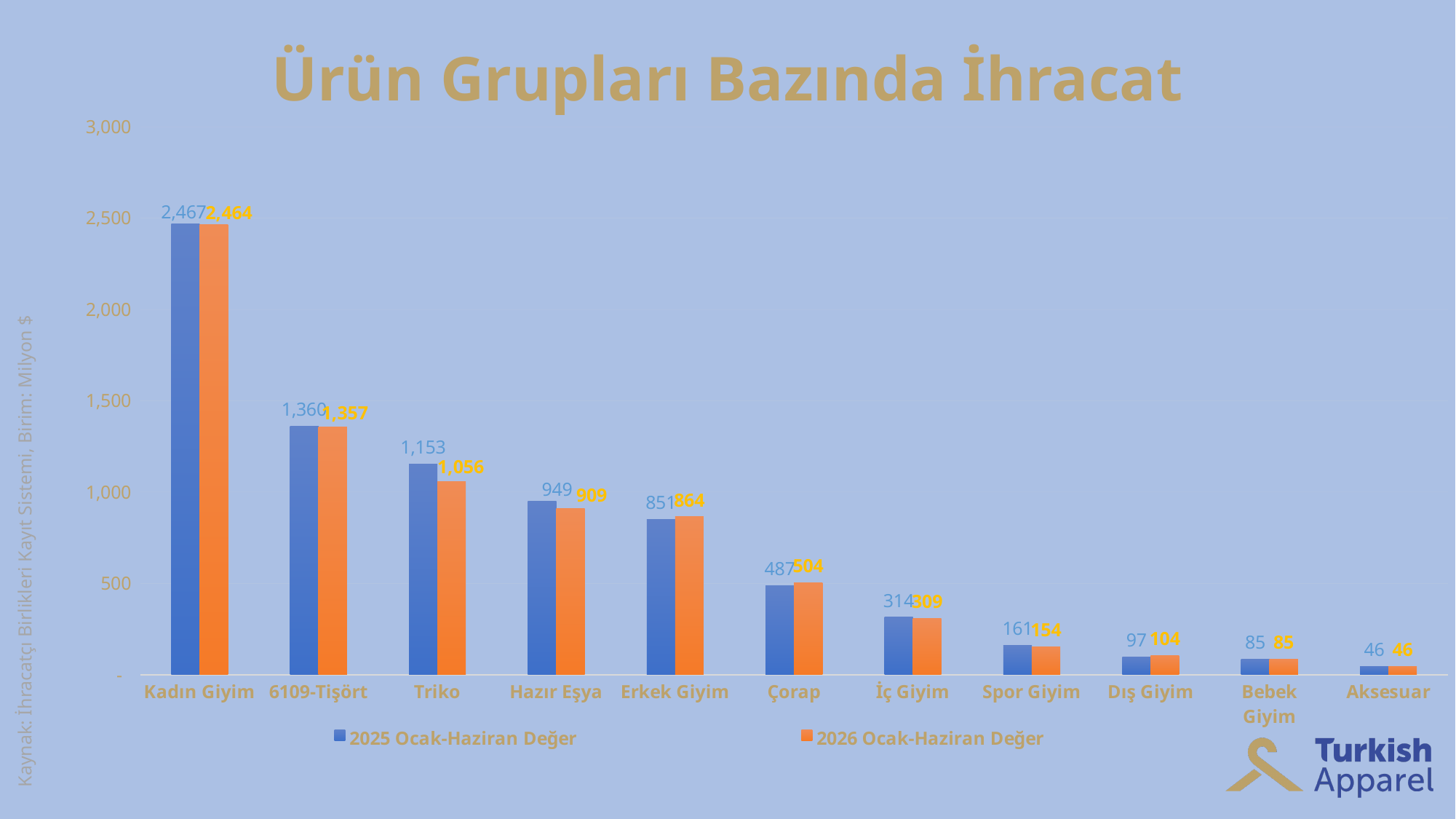
Is the 2025 Ocak-Haziran Değer for 6109-Tişört greater or less than 1,000? greater Which product group has the highest 2025 Ocak-Haziran Değer? Kadın Giyim What is the 2025 Ocak-Haziran Değer for Triko? 1,153 What is the difference between the 2025 and 2026 Ocak-Haziran Değer for Triko? 97 What is the 2026 Ocak-Haziran Değer for Kadın Giyim? 2,464 Which product group has the lowest 2026 Ocak-Haziran Değer? Aksesuar What is the title of the chart? Ürün Grupları Bazında İhracat How many product groups are shown on the x axis? 11 How many series does the legend list? 2 What kind of chart is shown on the slide? Bar chart For Erkek Giyim, which is larger: the 2025 Ocak-Haziran Değer or the 2026 Ocak-Haziran Değer? 2026 Ocak-Haziran Değer What is the 2026 Ocak-Haziran Değer for Çorap? 504